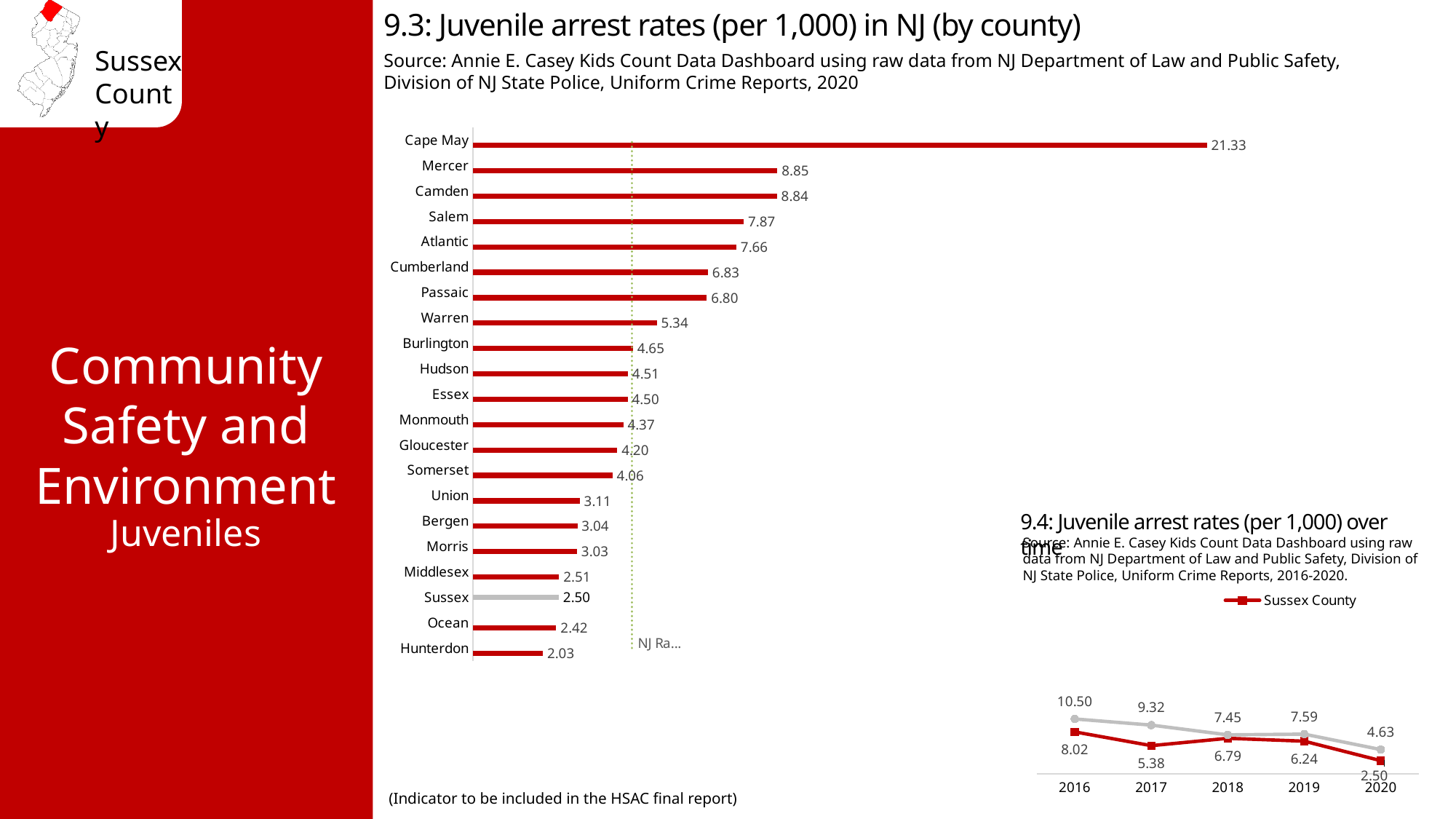
In the chart '9.4: Juvenile arrest rates (per 1,000) over time', what is the value for Sussex County in 2020? 2.50 In the chart '9.3: Juvenile arrest rates (per 1,000) in NJ (by county)', how many counties are shown? 21 In the chart '9.3: Juvenile arrest rates (per 1,000) in NJ (by county)', which has a larger value, Warren or Burlington? Warren In the chart '9.3: Juvenile arrest rates (per 1,000) in NJ (by county)', what is the difference between the values for Mercer and Sussex? 6.35 In the chart '9.3: Juvenile arrest rates (per 1,000) in NJ (by county)', which county has the lowest value? Hunterdon In the chart '9.3: Juvenile arrest rates (per 1,000) in NJ (by county)', what is the value for Sussex? 2.50 In the chart '9.4: Juvenile arrest rates (per 1,000) over time', what is the difference between the Sussex County values for 2016 and 2020? 5.52 In the chart '9.3: Juvenile arrest rates (per 1,000) in NJ (by county)', which county has the highest value? Cape May In the chart '9.4: Juvenile arrest rates (per 1,000) over time', what is the value for Sussex County in 2016? 8.02 In the chart '9.3: Juvenile arrest rates (per 1,000) in NJ (by county)', what is the value for Cape May? 21.33 What kind of chart is '9.3: Juvenile arrest rates (per 1,000) in NJ (by county)'? Bar chart In the chart '9.4: Juvenile arrest rates (per 1,000) over time', how many years are shown on the x axis? 5